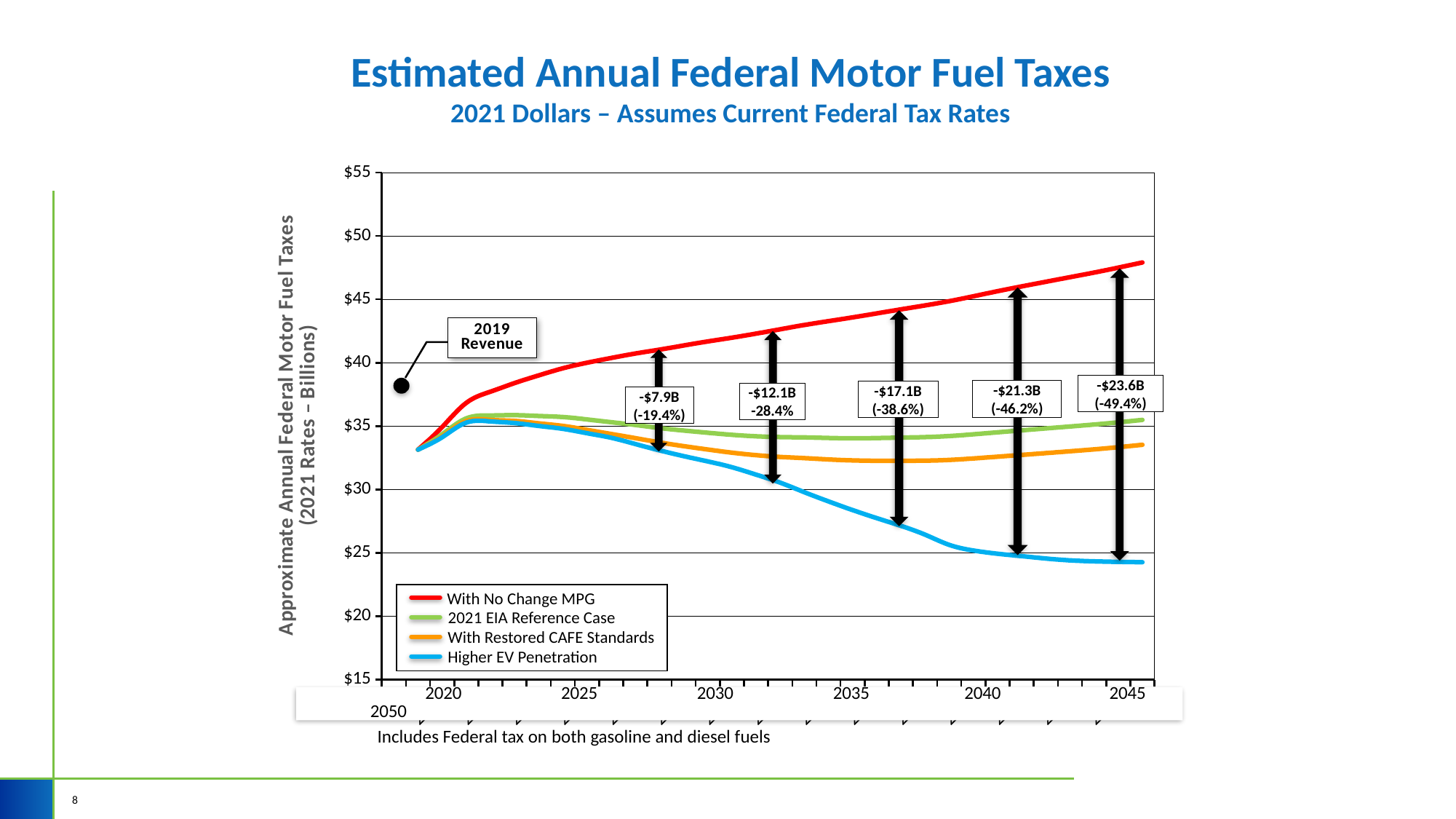
What is the title of the chart? Estimated Annual Federal Motor Fuel Taxes Is the value for With No Change MPG in 2045 greater or less than $45? greater Which series has the lowest value in 2045? Higher EV Penetration In 2035, which is larger: 2021 EIA Reference Case or With Restored CAFE Standards? 2021 EIA Reference Case What kind of chart is shown on the slide? line chart Is the value for Higher EV Penetration in 2045 greater or less than $30? less What colour is the Higher EV Penetration line in the legend? blue What dollar gap and percentage are annotated between the top and bottom lines at 2045? -$23.6B (-49.4%) Which series has the highest value in 2045? With No Change MPG How many series does the legend list? 4 What percentage is shown alongside the -$17.1B annotation? -38.6% Does the With No Change MPG line rise or fall from 2020 to 2045? rise